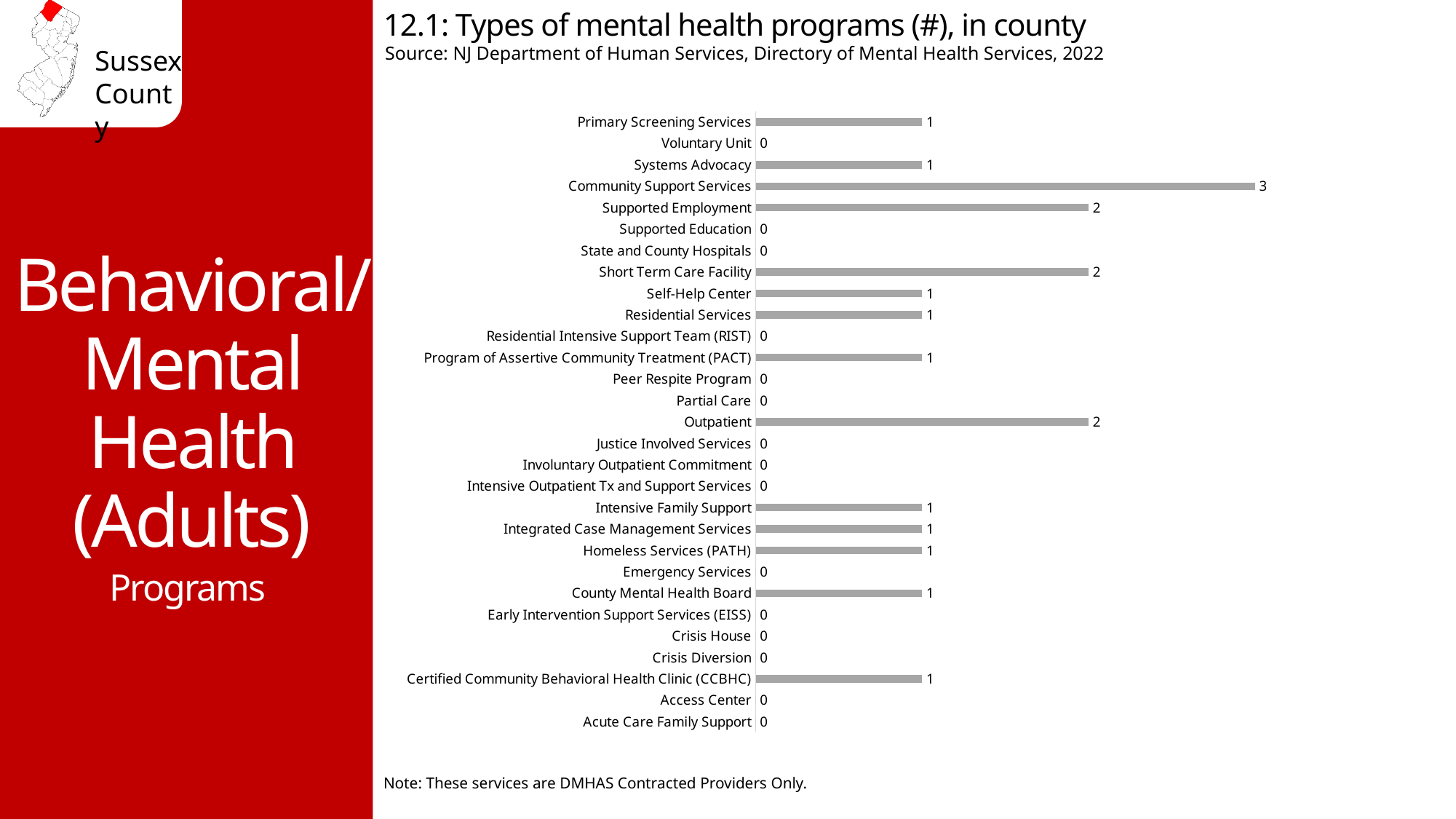
How many Community Support Services programs are there in the county? 3 What is the source cited for the chart data? NJ Department of Human Services, Directory of Mental Health Services, 2022 How many program types have a value of 2? 3 Which type of mental health program has the highest count in the county? Community Support Services Which is larger, the value for Short Term Care Facility or the value for Self-Help Center? Short Term Care Facility What type of chart is shown on the slide? bar chart What is the value for Crisis House? 0 What is the difference between the values for Community Support Services and Outpatient? 1 How many program types are listed in the chart? 29 What is the title of the chart? 12.1: Types of mental health programs (#), in county What is the value for Supported Employment? 2 What is the value for Program of Assertive Community Treatment (PACT)? 1